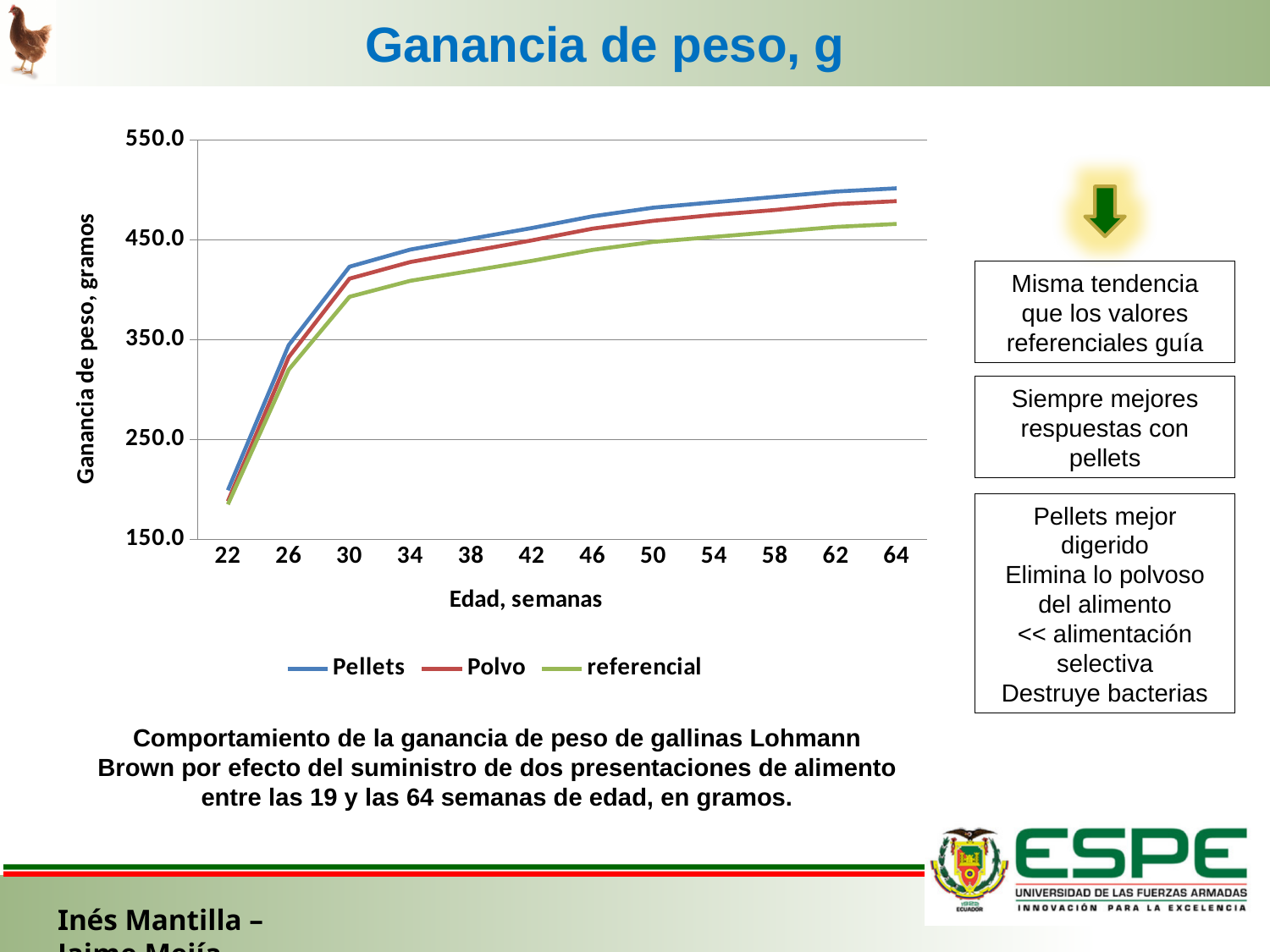
What is the title of the x axis? Edad, semanas At 30 weeks, which is larger: the value for Pellets or the value for referencial? Pellets How many age values are labelled on the x axis? 12 Is the value for Pellets at 22 weeks greater or less than 250.0? less Which series has the lowest value at 64 weeks? referencial Do the values for Pellets rise or fall as age increases from 22 to 64 weeks? rise Which series has the highest value at 64 weeks? Pellets What is the title of the y axis? Ganancia de peso, gramos What kind of chart is shown on the slide? line chart Is the value for referencial at 30 weeks greater or less than 350.0? greater Is the value for Pellets at 64 weeks greater or less than 450.0? greater How many series does the legend list? 3